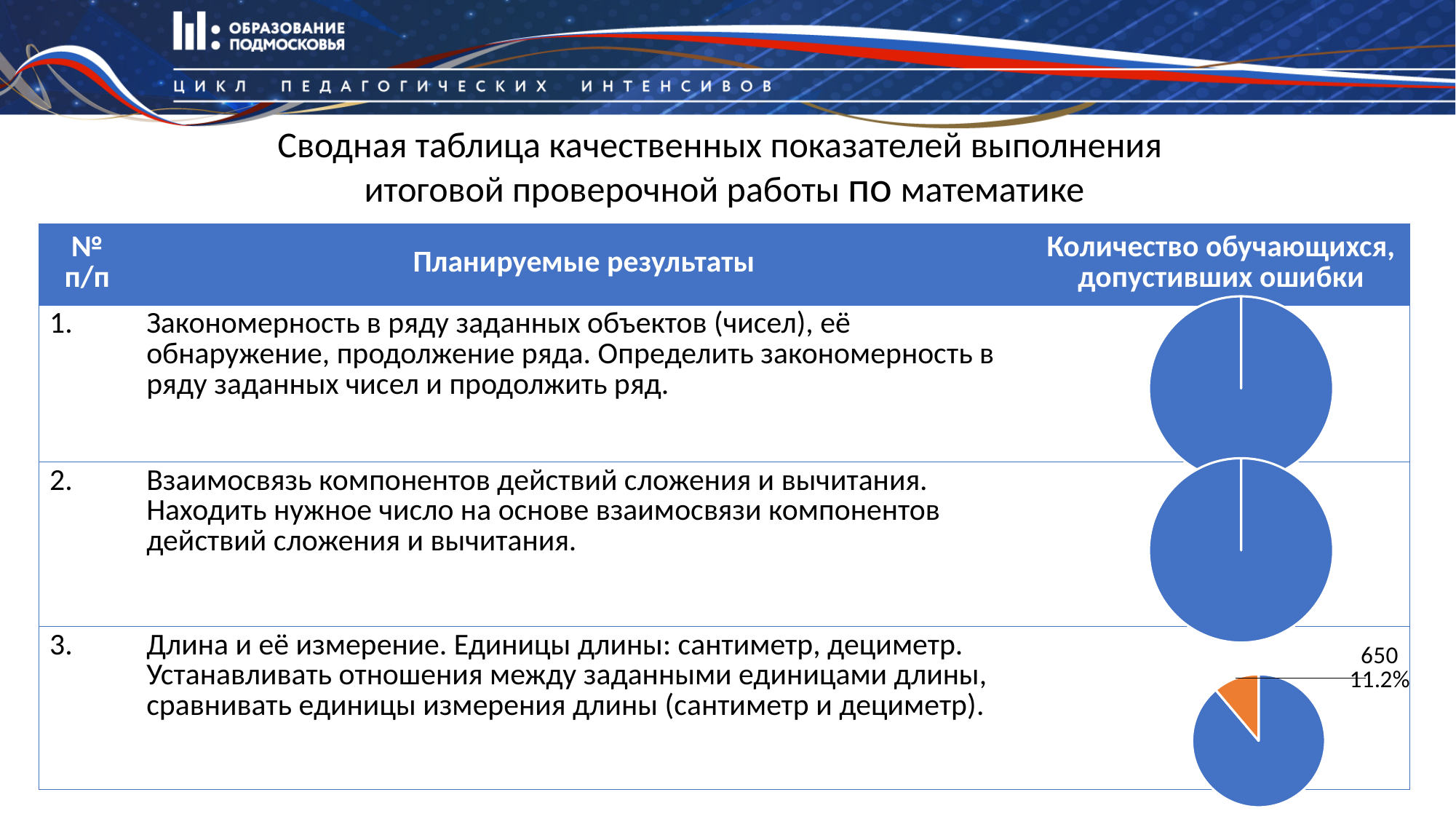
In the pie chart in row 3, what value is printed on the data label of the orange slice? 650 How many pie charts are shown on the slide? 3 How many visibly distinct slices does the pie chart in row 3 have? 2 In the pie chart in row 3, which slice is larger, the blue one or the orange one? blue What colour fills almost the entire pie chart in row 1? blue In the pie chart in row 3, is the share of the orange slice greater or less than 50%? less Which of the three pie charts on the slide has a visible orange slice? the one in row 3 What kind of chart is shown in the third row of the table (row 3)? pie chart In the pie chart in row 3, what percentage share is printed for the orange slice? 11.2%